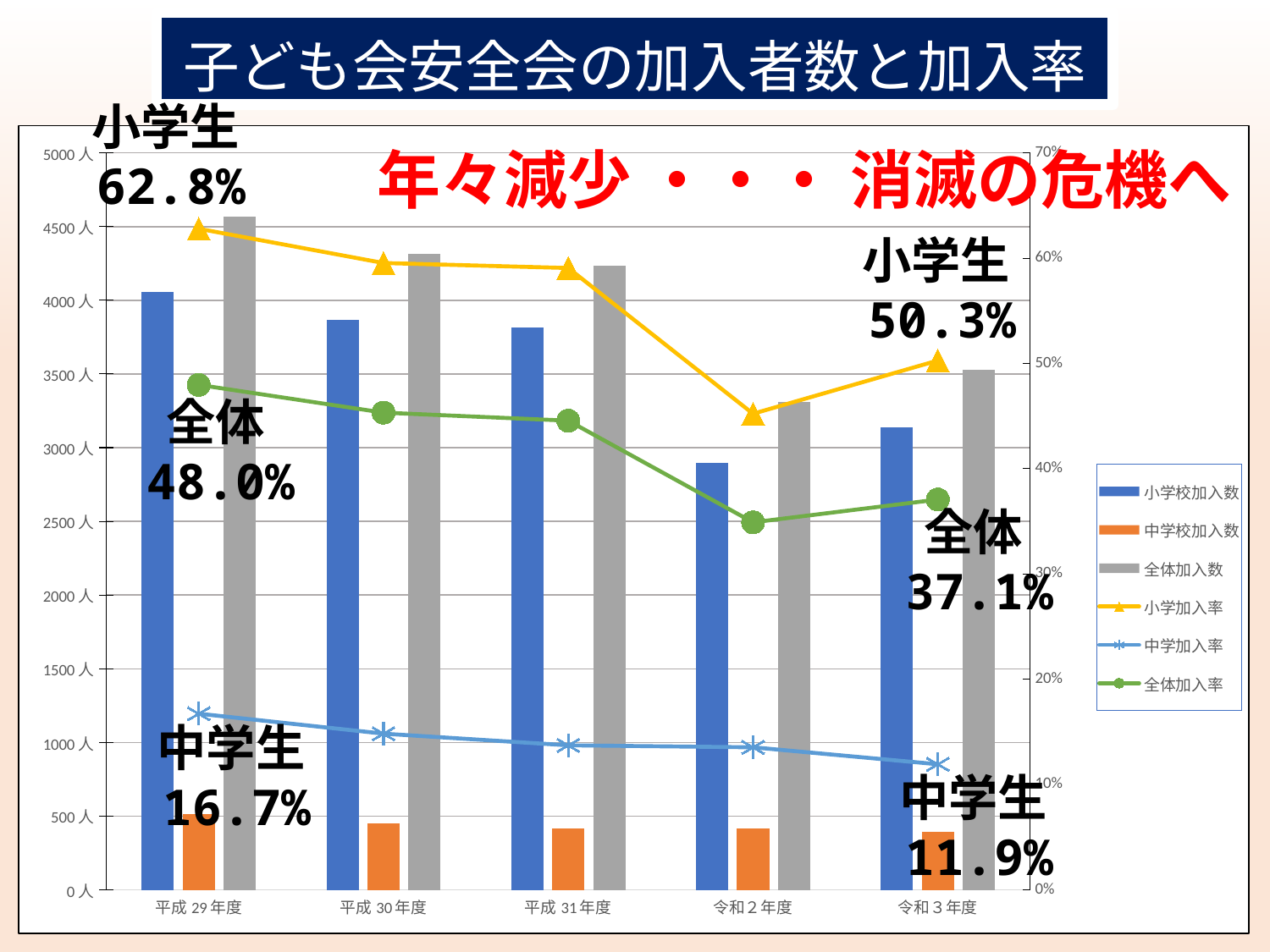
What is the 小学加入率 (elementary school enrollment rate) for 平成29年度? 62.8% Is the 中学校加入数 bar for 令和3年度 greater or less than 500人? less By how many percentage points did the 小学加入率 fall from 平成29年度 to 令和3年度? 12.5 percentage points How many series does the legend list? 6 Which fiscal year has the highest 小学校加入数 bar? 平成29年度 What is the 中学加入率 (junior high enrollment rate) for 令和3年度? 11.9% What is the 小学加入率 for 令和3年度? 50.3% What is the 全体加入率 for 令和3年度? 37.1% By how many percentage points did the 全体加入率 fall from 平成29年度 to 令和3年度? 10.9 percentage points What is the 全体加入率 (overall enrollment rate) for 平成29年度? 48.0% How many fiscal years are shown on the x axis? 5 Does the 中学加入率 line rise or fall from 平成29年度 to 令和3年度? fall